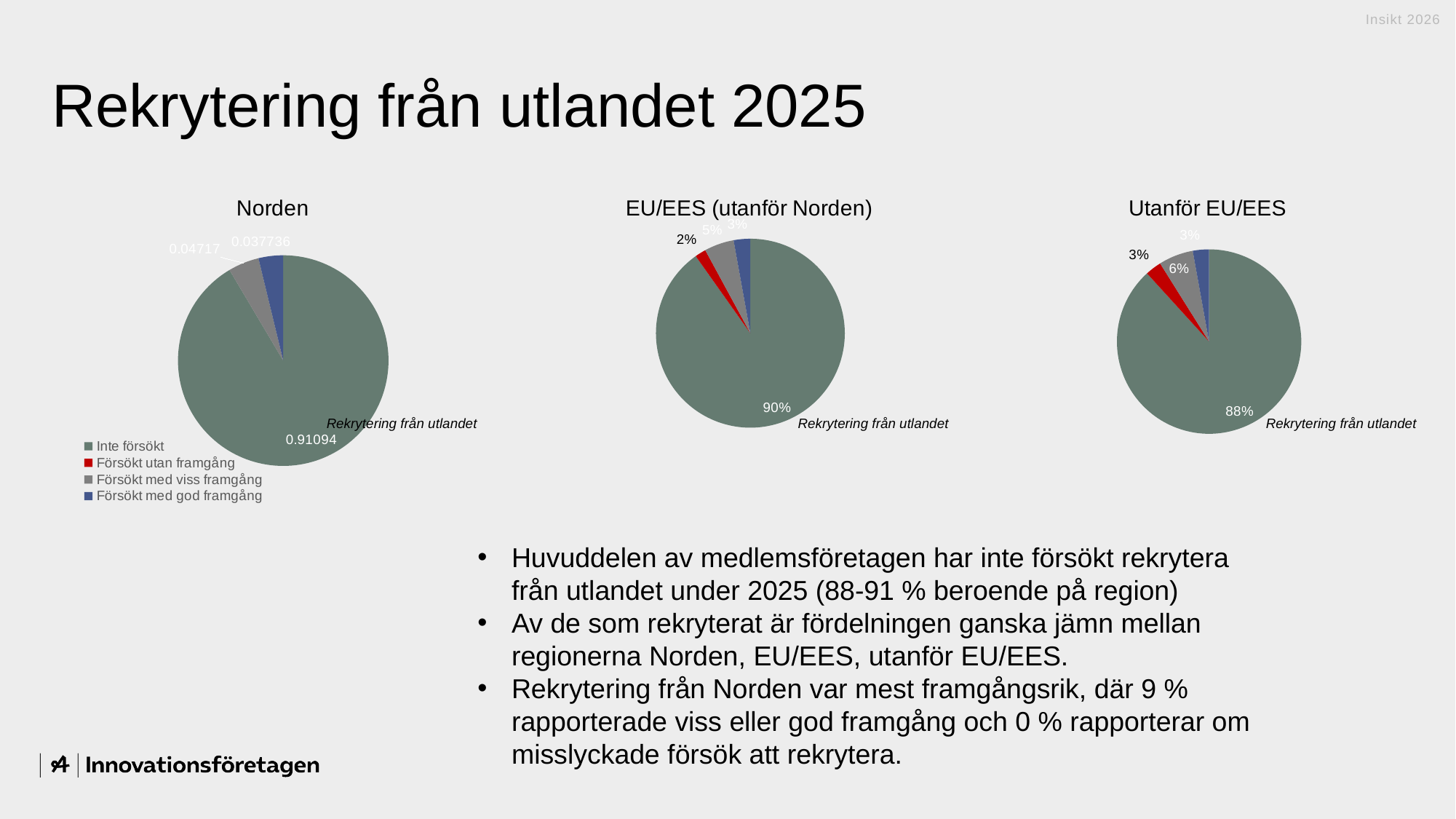
In the EU/EES (utanför Norden) chart, what share is Försökt med viss framgång? 5% In the Utanför EU/EES chart, what share is Inte försökt? 88% In the Norden chart, what value is shown for Försökt med viss framgång? 0.04717 In the EU/EES (utanför Norden) chart, what share is Inte försökt? 90% In the Utanför EU/EES chart, which category has the largest slice? Inte försökt In the Norden chart, what value is shown for Försökt med god framgång? 0.037736 How many entries does the legend list? 4 In the Utanför EU/EES chart, what is the difference between the Inte försökt share and the Försökt med viss framgång share? 82% In the Norden chart, what value is shown for Inte försökt? 0.91094 What kind of chart is used for the Norden data? pie chart